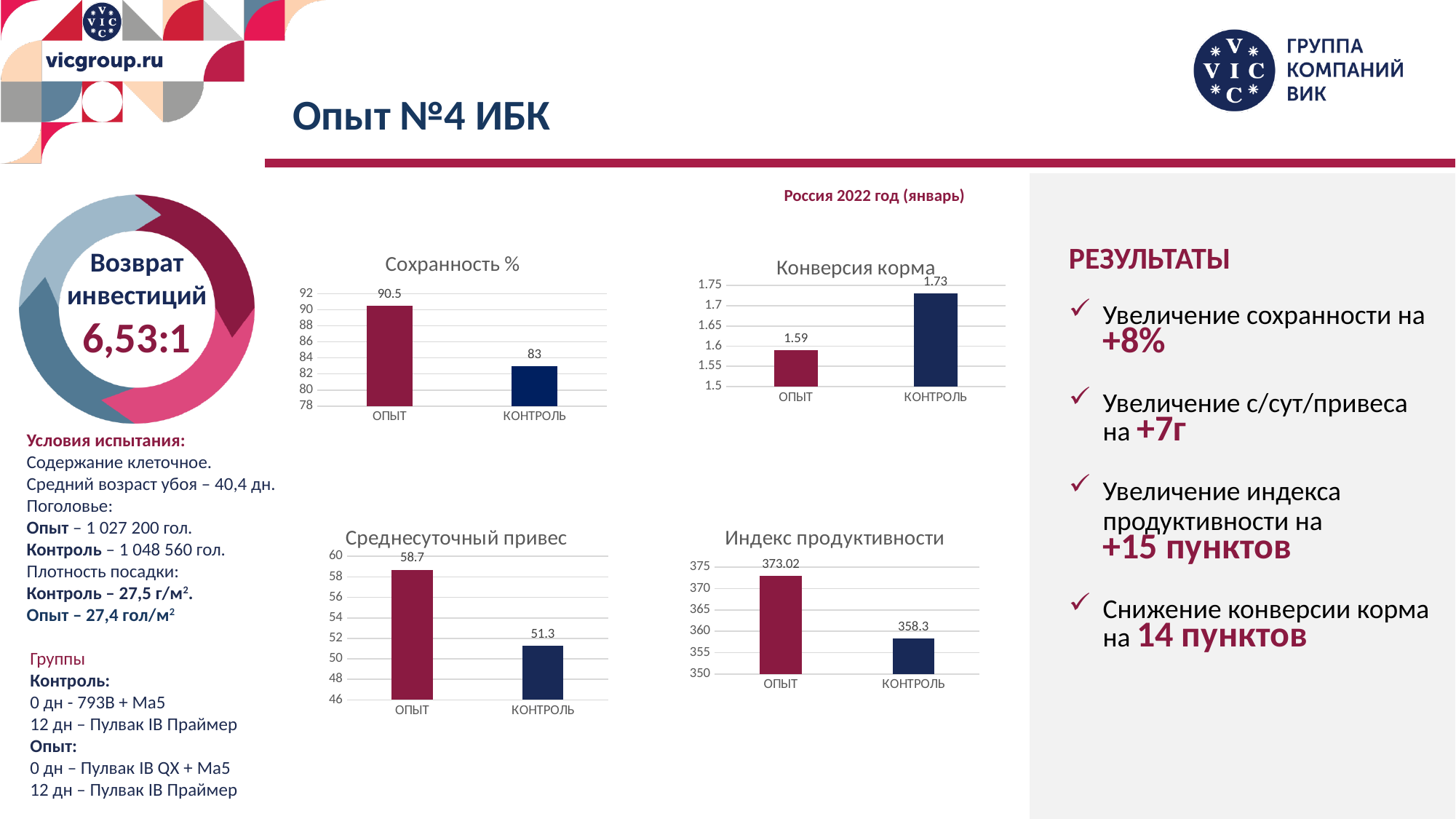
How many categories are shown in the 'Индекс продуктивности' chart? 2 In the 'Индекс продуктивности' chart, what is the value for КОНТРОЛЬ? 358.3 What type of chart is 'Среднесуточный привес'? Bar chart In the 'Конверсия корма' chart, what is the difference between КОНТРОЛЬ and ОПЫТ? 0.14 In the 'Среднесуточный привес' chart, which is larger, ОПЫТ or КОНТРОЛЬ? ОПЫТ In the 'Сохранность %' chart, what is the value for ОПЫТ? 90.5 In the 'Индекс продуктивности' chart, which category has the highest value? ОПЫТ In the 'Сохранность %' chart, what is the difference between ОПЫТ and КОНТРОЛЬ? 7.5 In the 'Конверсия корма' chart, what is the value for КОНТРОЛЬ? 1.73 In the 'Конверсия корма' chart, which category has the lowest value? ОПЫТ In the 'Сохранность %' chart, what is the value for КОНТРОЛЬ? 83 In the 'Среднесуточный привес' chart, what is the value for ОПЫТ? 58.7